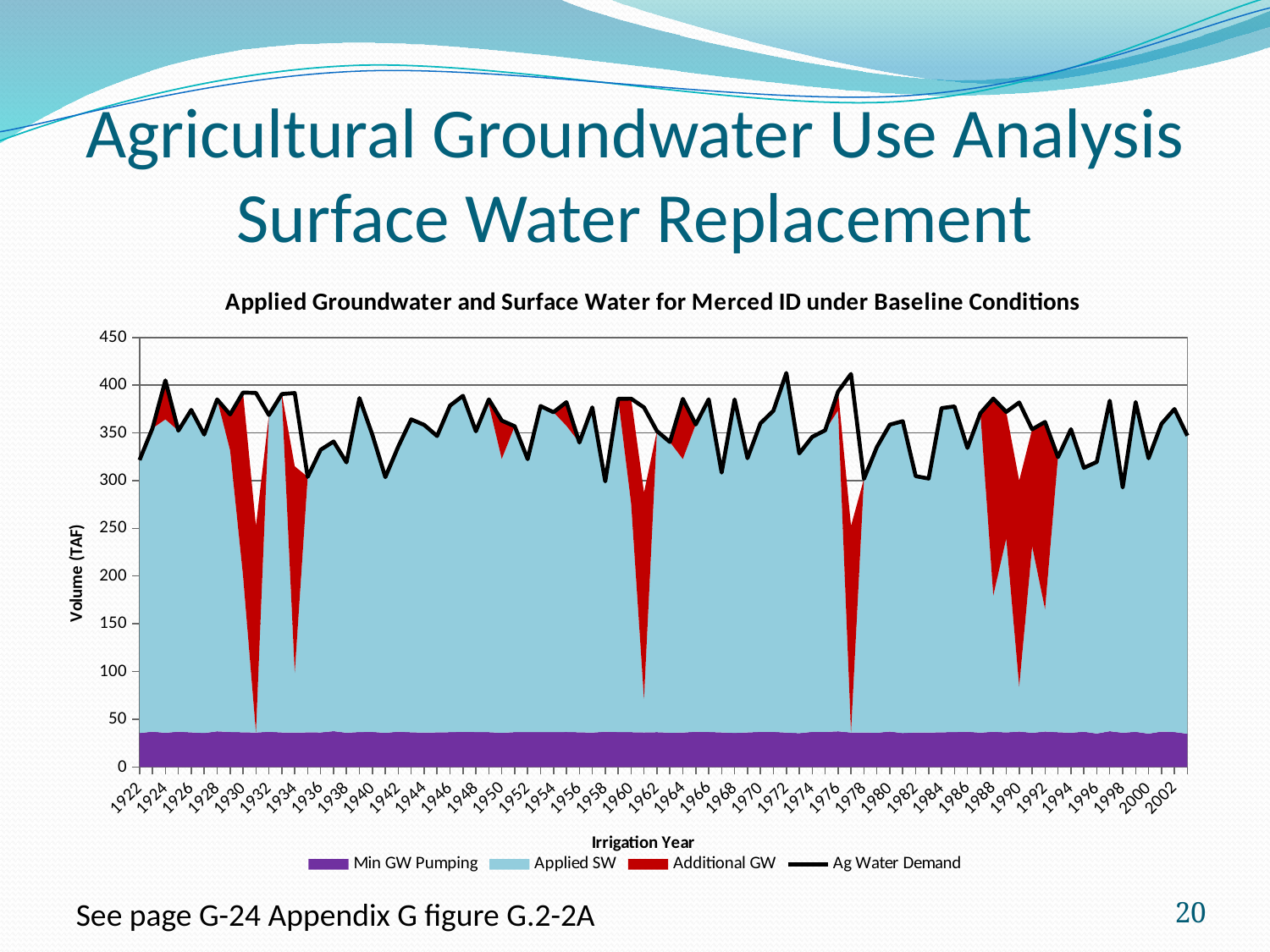
What is the title of the chart? Applied Groundwater and Surface Water for Merced ID under Baseline Conditions What is the highest value shown on the vertical axis? 450 Which series is drawn as a black line rather than a filled area? Ag Water Demand How many series does the legend list? 4 Is the Ag Water Demand value for 1972 greater or less than 400? greater What is the last year labeled on the horizontal axis? 2002 What is the first year labeled on the horizontal axis? 1922 What is the label of the vertical axis? Volume (TAF) Is the Ag Water Demand value for 1922 greater or less than 350? less What kind of chart is shown on the slide? Stacked area chart with a line series What is the label of the horizontal axis? Irrigation Year Is the Min GW Pumping value for 1950 greater or less than 50? less